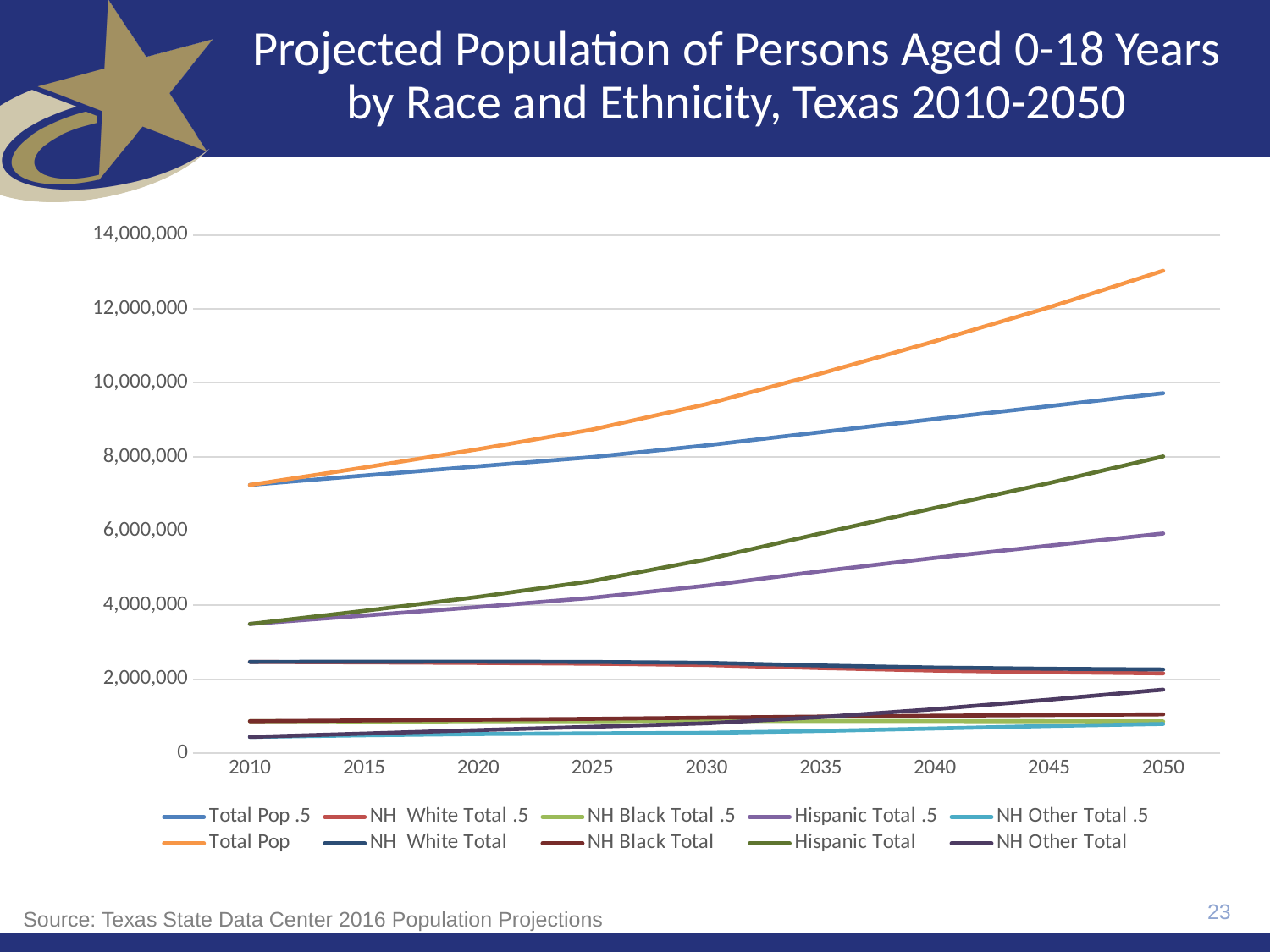
Is the value for Total Pop .5 in 2050 greater or less than 10,000,000? less Does the NH White Total .5 series rise or fall from 2010 to 2050? Fall Is the value for Hispanic Total in 2010 greater or less than 4,000,000? less In 2050, which is larger: Hispanic Total or NH White Total? Hispanic Total What kind of chart is shown on the slide? Line chart Is the value for Total Pop in 2050 greater or less than 12,000,000? greater How many series does the legend list? 10 Which series has the highest value in 2050? Total Pop Does the Total Pop series rise or fall from 2010 to 2050? Rise What is the title of the chart? Projected Population of Persons Aged 0-18 Years by Race and Ethnicity, Texas 2010-2050 How many year labels are shown along the x axis? 9